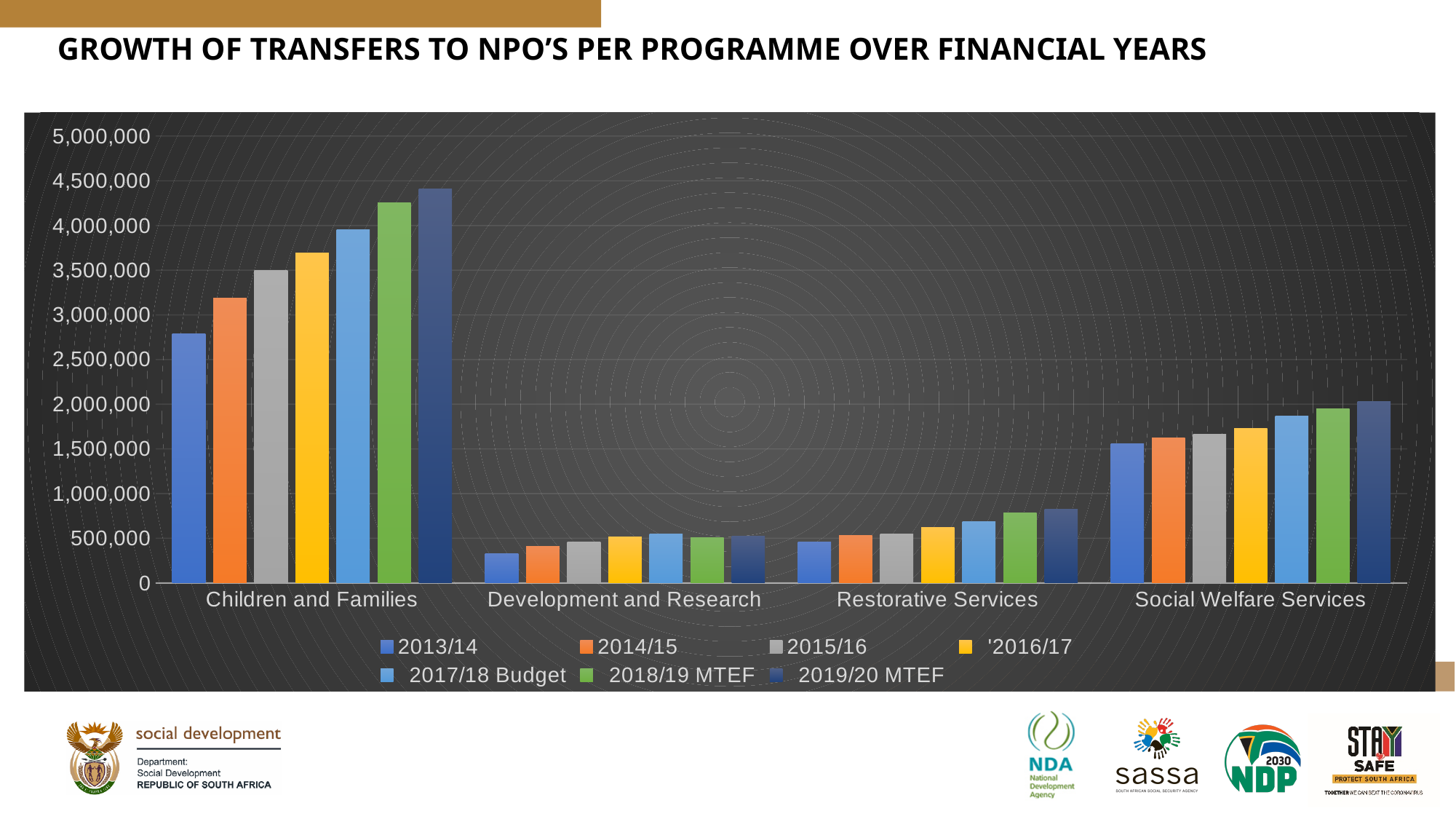
Is the 2013/14 value for Social Welfare Services greater or less than 2,000,000? less Which is larger: the 2019/20 MTEF value for Restorative Services or for Development and Research? Restorative Services How many series does the legend list? 7 Is the 2019/20 MTEF value for Children and Families greater or less than 4,000,000? greater What is the title of the slide? GROWTH OF TRANSFERS TO NPO'S PER PROGRAMME OVER FINANCIAL YEARS Which programme has the highest 2019/20 MTEF transfer value? Children and Families Is the 2013/14 value for Children and Families greater or less than 2,500,000? greater How many programme categories are shown on the x axis? 4 What colour represents the 2018/19 MTEF series in the legend? Green What kind of chart is shown on the slide? Bar chart Which programme has the lowest 2013/14 transfer value? Development and Research Do the transfers for Children and Families rise or fall from 2013/14 to 2019/20 MTEF? Rise